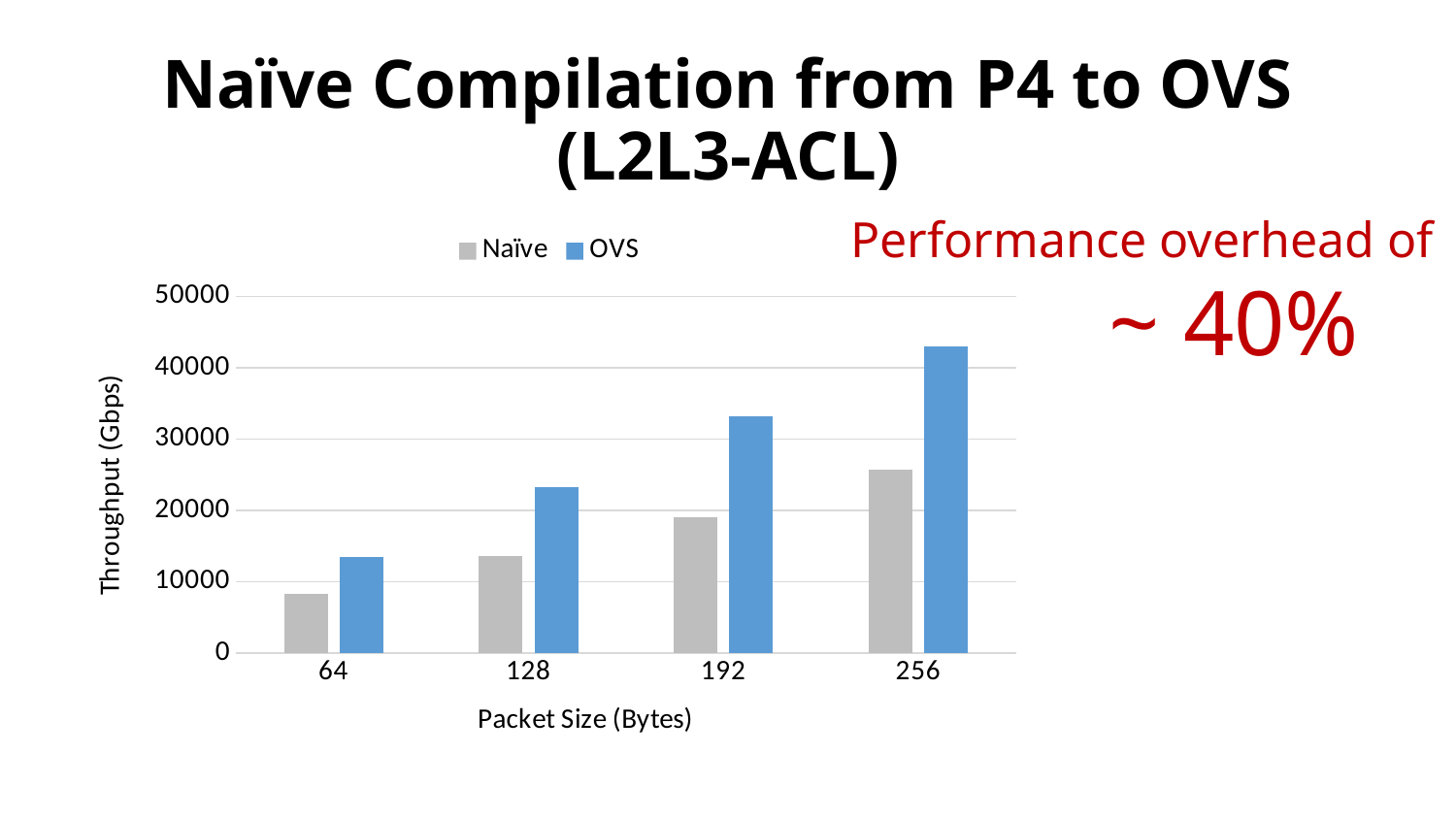
What kind of chart is shown on the slide? bar chart Is the Naïve throughput at packet size 64 greater or less than 10000? less Which series is shown in blue? OVS What is the label of the y axis? Throughput (Gbps) Which packet size has the highest OVS throughput? 256 How many packet size categories are shown on the x axis? 4 How many series does the legend list? 2 Does the OVS throughput rise or fall as packet size increases? rise At packet size 128, which series has the larger throughput, Naïve or OVS? OVS Is the OVS throughput at packet size 256 greater or less than 40000? greater Which packet size has the lowest Naïve throughput? 64 Is the OVS throughput at packet size 192 greater or less than 30000? greater